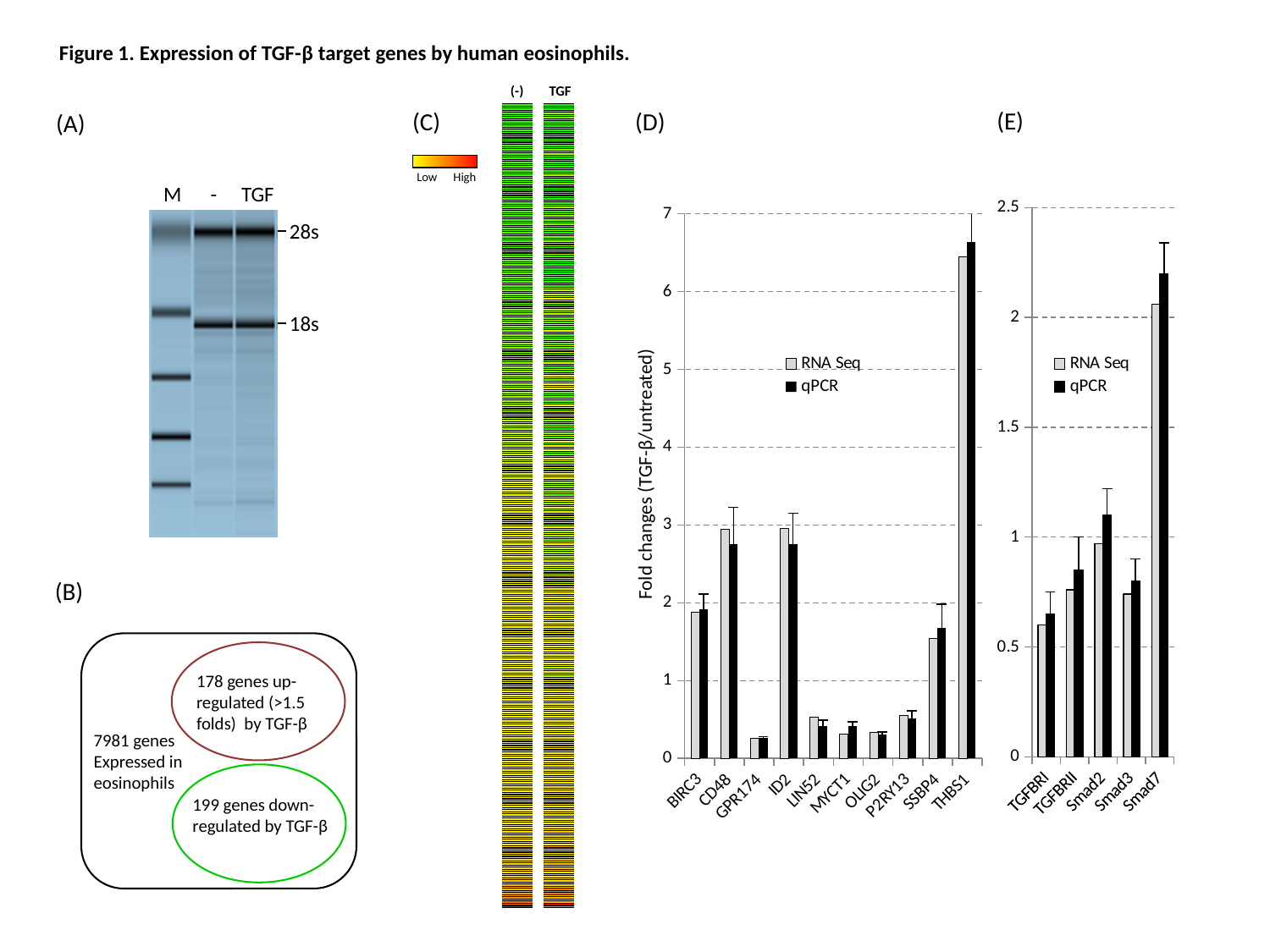
In chart (E), which gene has the highest fold change? Smad7 In chart (D), which gene has the highest fold change? THBS1 In chart (E), is the RNA Seq value for Smad7 greater or less than 2? greater In chart (E), which gene has the lowest fold change? TGFBRI What kind of chart is chart (E)? Bar chart In chart (E), is the RNA Seq value for Smad3 greater or less than 1? less How many series does the legend of chart (E) list? 2 How many genes are shown on the x axis of chart (D)? 10 In chart (D), which has the larger RNA Seq fold change, CD48 or LIN52? CD48 In chart (D), which gene has the lowest fold change? GPR174 In chart (D), is the qPCR value for THBS1 greater or less than 6? greater